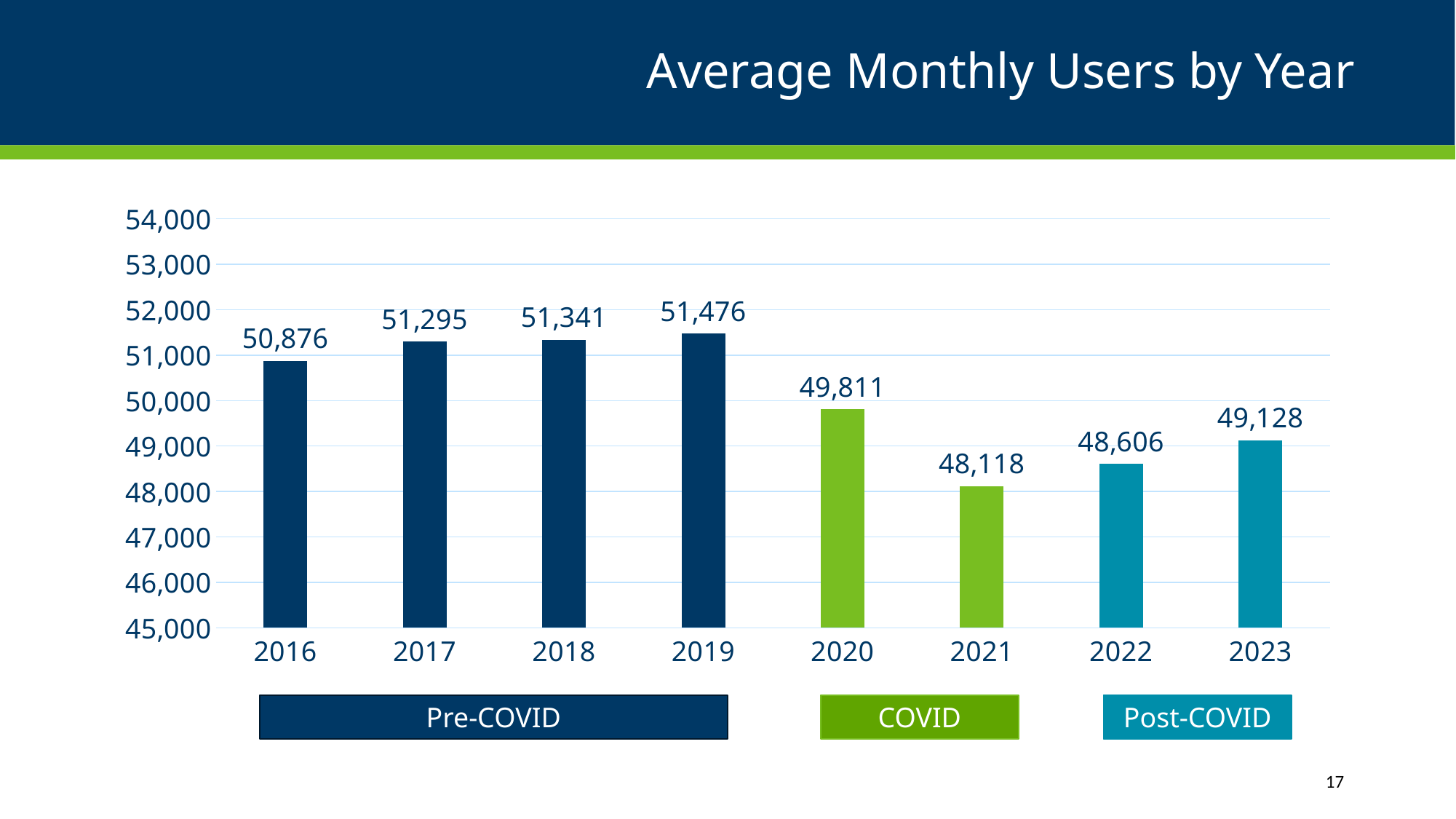
How many years are shown on the chart? 8 What kind of chart is shown on the slide? bar chart What is the difference between the 2019 and 2021 values? 3,358 What is the average monthly users value for 2023? 49,128 Which period label is shown under the 2020 and 2021 bars? COVID Which year has the highest average monthly users? 2019 What is the average monthly users value for 2019? 51,476 Which is larger, the value for 2020 or the value for 2023? 2020 Is the value for 2022 greater or less than 49,000? less Which year has the lowest average monthly users? 2021 What is the average monthly users value for 2021? 48,118 What is the difference between the 2023 and 2022 values? 522